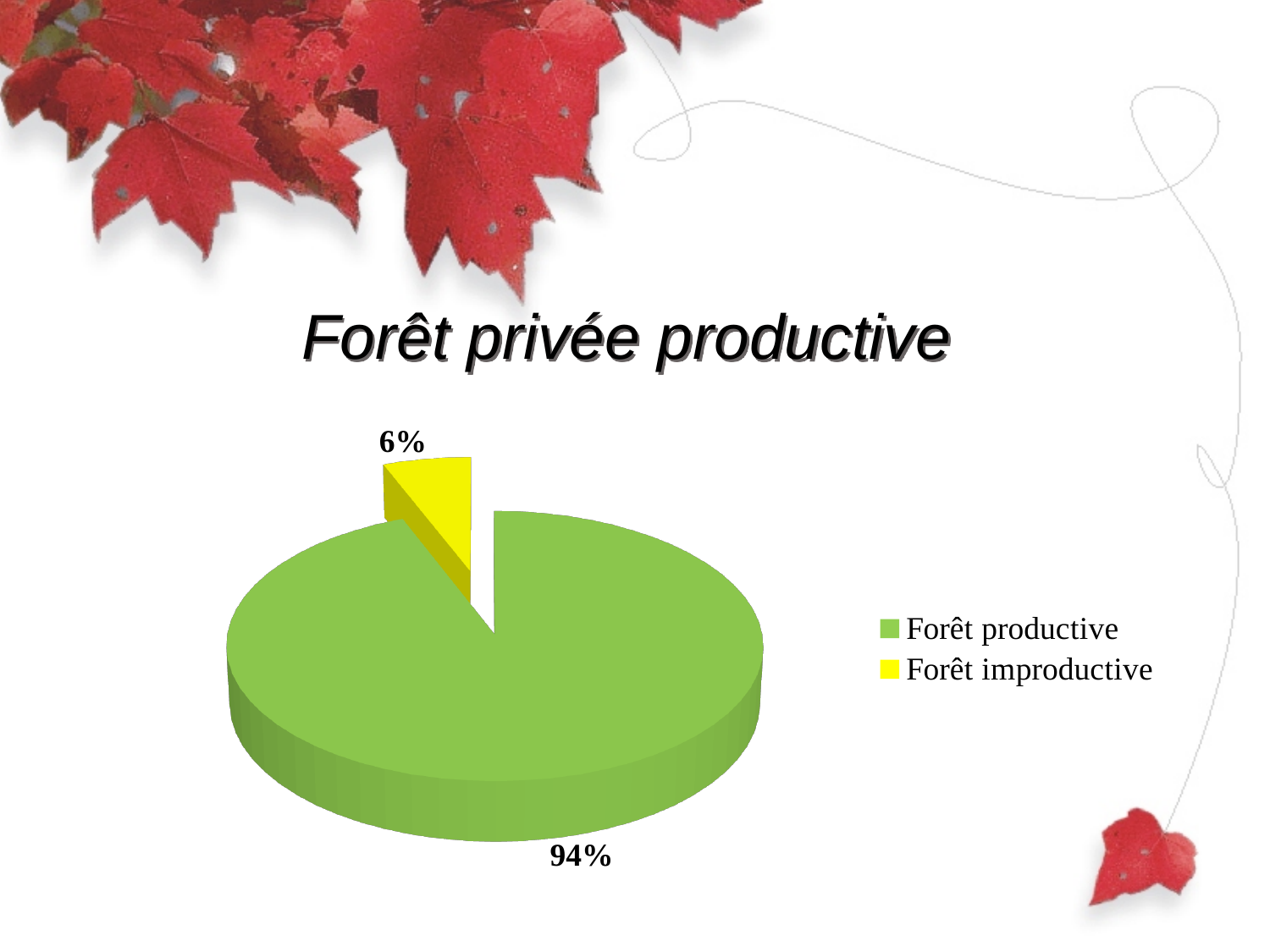
What share of the pie does Forêt productive represent? 94% Which category has the smallest slice of the pie? Forêt improductive What colour is the slice for Forêt improductive? yellow How many slices does the pie chart have? 2 What is the title of the chart? Forêt privée productive How many entries does the legend list? 2 Which is larger, the slice for Forêt productive or the slice for Forêt improductive? Forêt productive What share of the pie does Forêt improductive represent? 6% What kind of chart is shown on the slide? pie chart Which category has the largest slice of the pie? Forêt productive What is the difference in percentage points between Forêt productive and Forêt improductive? 88